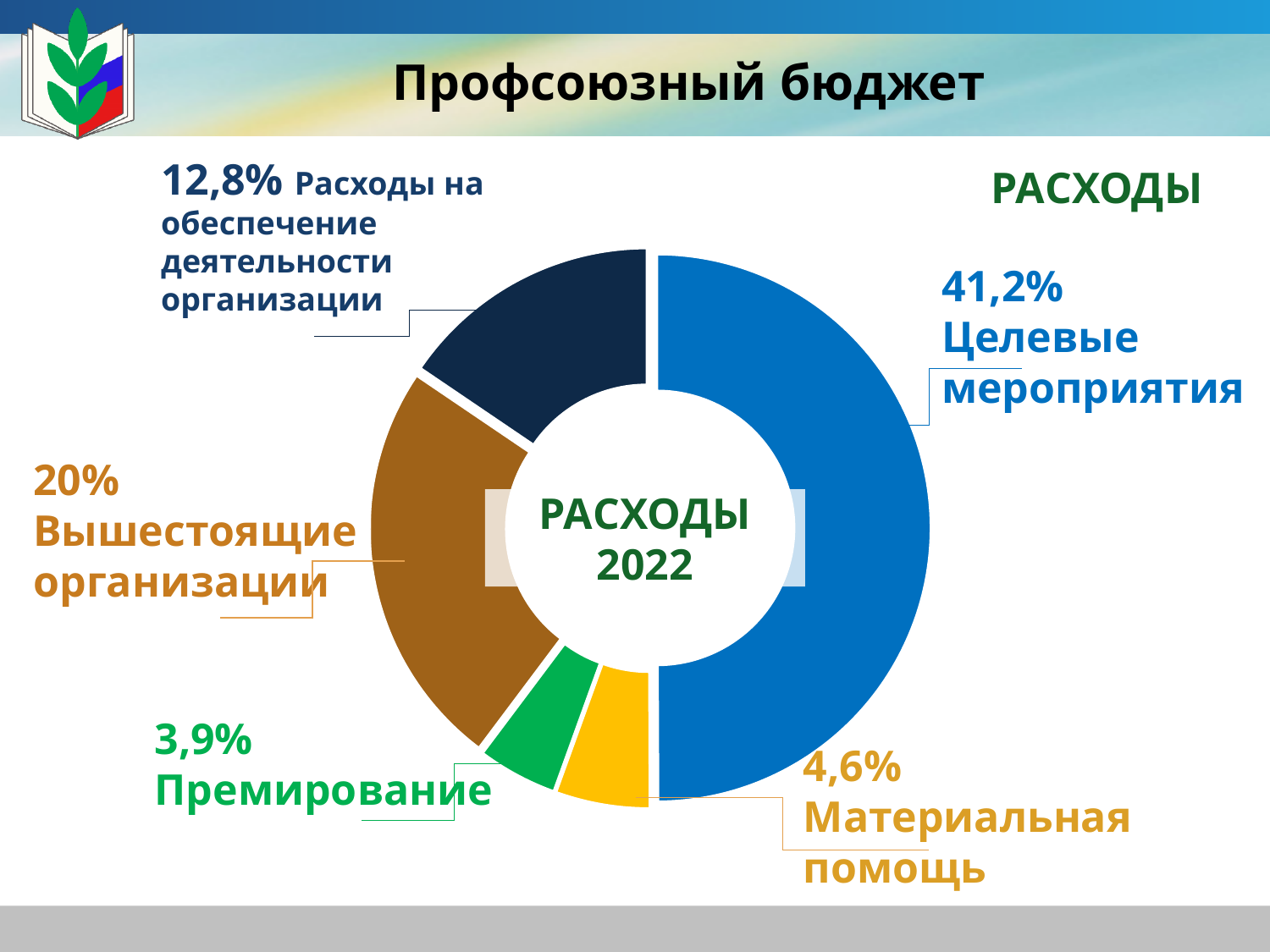
What percentage is shown for Премирование? 3,9% Which category has the smallest share of expenses? Премирование What is the difference in percentage points between Целевые мероприятия and Вышестоящие организации? 21,2 Which is larger: the share for Материальная помощь or for Премирование? Материальная помощь What share of expenses goes to Целевые мероприятия? 41,2% What share is labelled for Материальная помощь? 4,6% Which category has the largest share of expenses? Целевые мероприятия What text appears in the centre of the chart? РАСХОДЫ 2022 How many categories are shown in the chart? 5 What share is given for Расходы на обеспечение деятельности организации? 12,8% What percentage is shown for Вышестоящие организации? 20% What kind of chart is shown on the slide? Doughnut (pie) chart